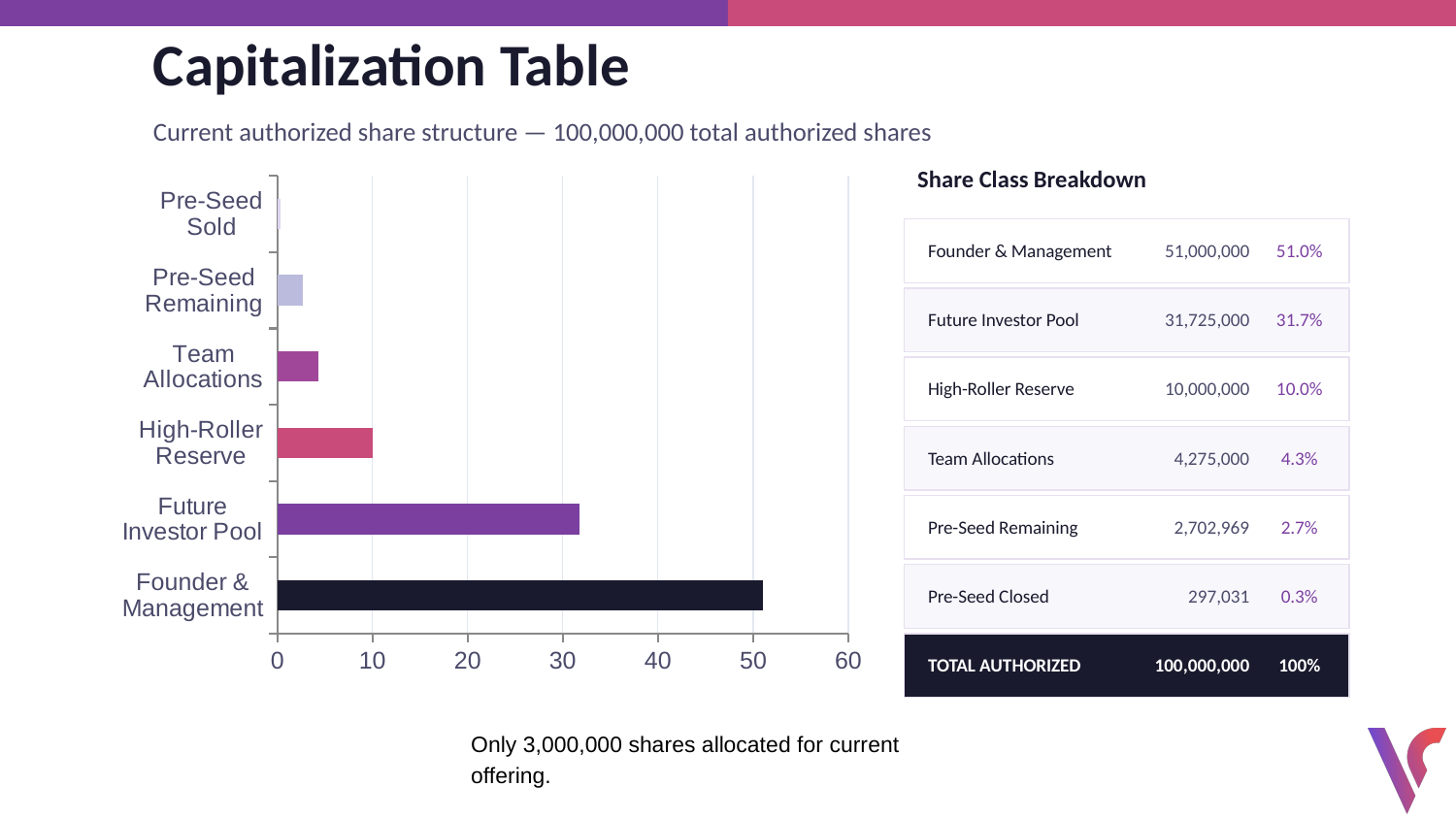
What is the highest tick value shown on the chart's horizontal axis? 60 How many categories are plotted in the bar chart? 6 What value does the High-Roller Reserve bar reach on the axis? 10 Which bar is longer: Team Allocations or Pre-Seed Remaining? Team Allocations Is the value for Founder & Management greater or less than 50? greater Which category has the longest bar in the chart? Founder & Management Which category has the shortest bar in the chart? Pre-Seed Sold What kind of chart is shown on the slide? bar chart Is the value for Team Allocations greater or less than 10? less Is the value for Future Investor Pool greater or less than 40? less Which bar is longer: Future Investor Pool or High-Roller Reserve? Future Investor Pool